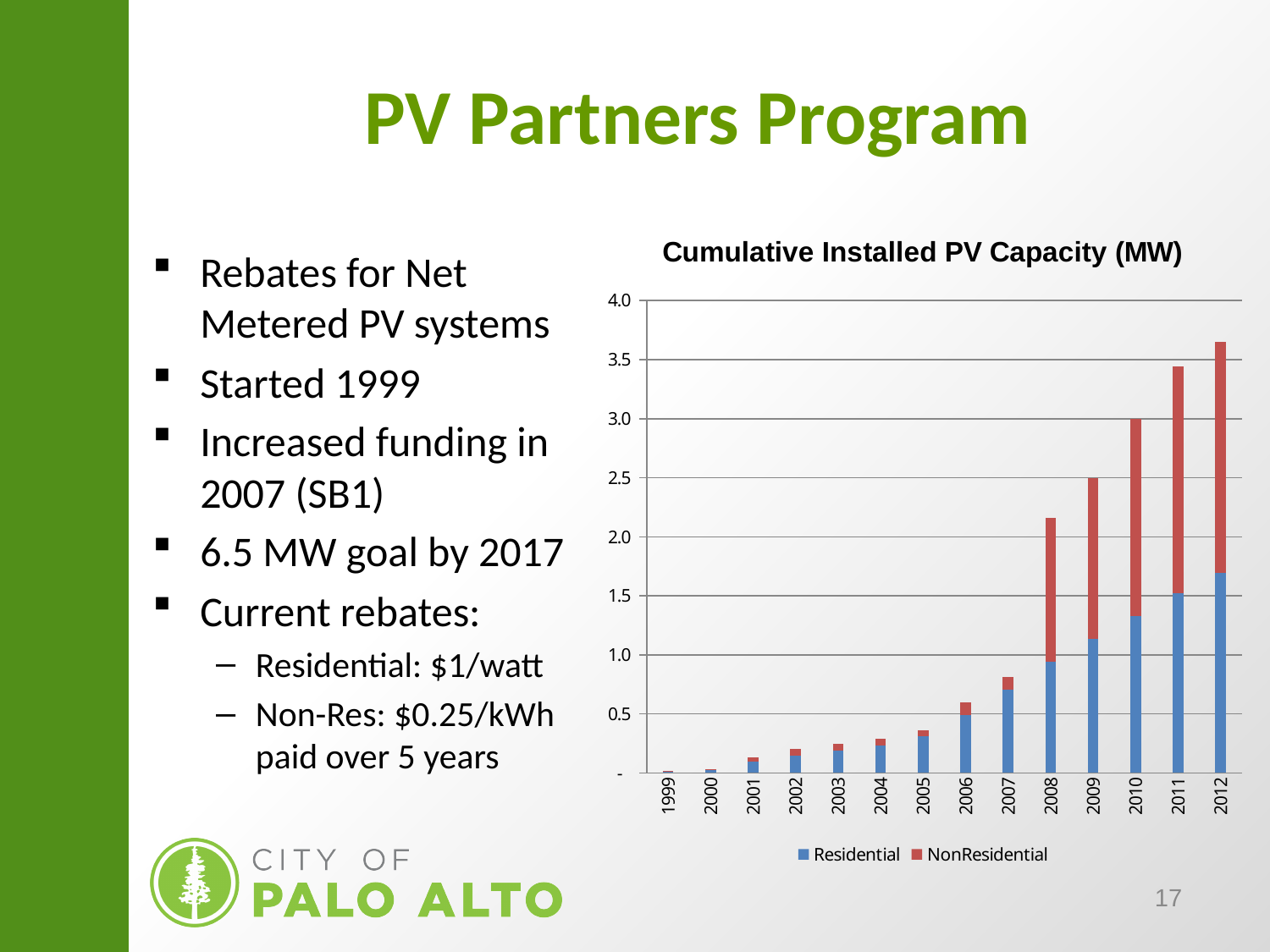
Which year has the lowest total cumulative installed PV capacity? 1999 Is the total value for 2008 greater or less than 2.0? greater Do the total bar heights rise or fall from 1999 to 2012? Rise Which year has a larger total bar, 2008 or 2012? 2012 How many years are shown on the x axis of the chart? 14 What is the title of the chart? Cumulative Installed PV Capacity (MW) Is the total value for 2007 greater or less than 1.0? less What kind of chart is shown on the slide? Stacked bar chart Which year has the highest total cumulative installed PV capacity? 2012 Is the total value for 2012 greater or less than 3.5? greater Which colour represents the NonResidential series in the chart? Red How many series does the chart legend list? 2